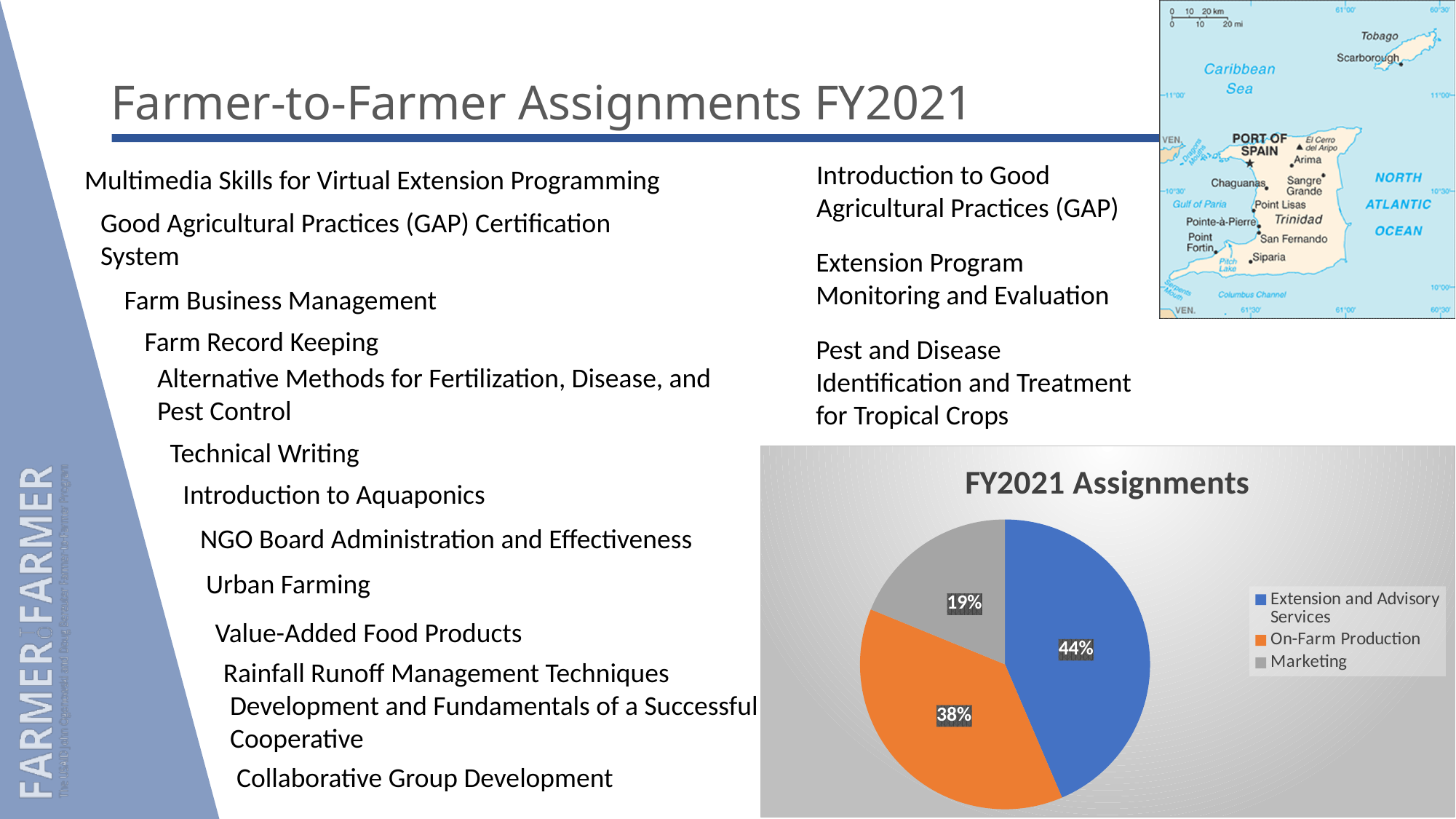
What is the title of the chart? FY2021 Assignments Which category has the smallest share of FY2021 assignments? Marketing What is the difference in percentage points between Extension and Advisory Services and On-Farm Production? 6 Which is larger, the share for On-Farm Production or the share for Marketing? On-Farm Production What share of FY2021 assignments is Extension and Advisory Services? 44% How many categories does the pie chart show? 3 What type of chart is shown on the slide? pie chart What share of FY2021 assignments is On-Farm Production? 38% How many entries does the legend list? 3 What share of FY2021 assignments is Marketing? 19% Which category has the largest share of FY2021 assignments? Extension and Advisory Services What colour represents Marketing in the pie chart? gray